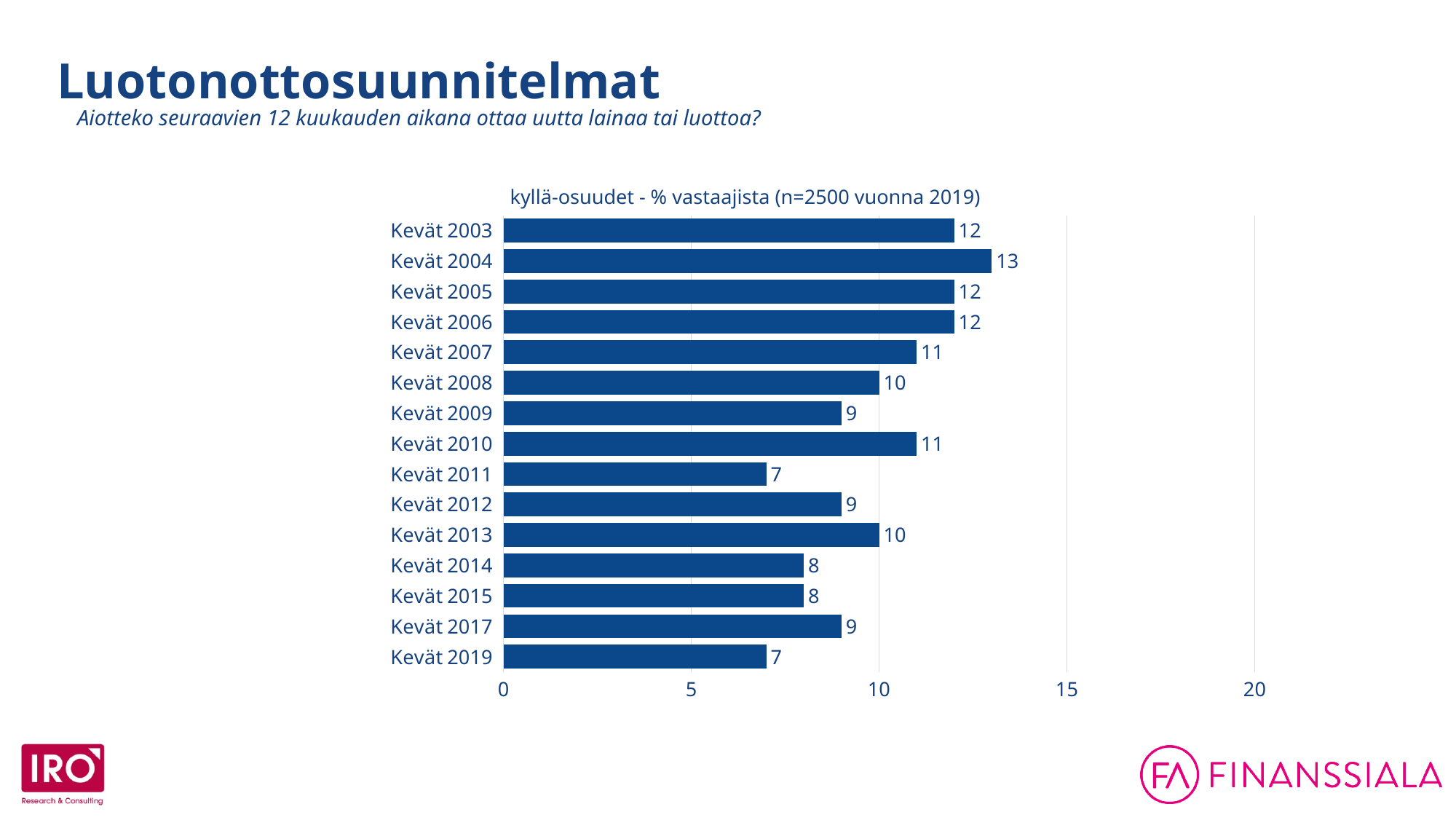
What is the value for Kevät 2019? 7 What is the title of the chart? kyllä-osuudet - % vastaajista (n=2500 vuonna 2019) How many categories are shown in the chart? 15 Which category has the highest value? Kevät 2004 What is the value for Kevät 2013? 10 What kind of chart is shown on the slide? bar chart Which is larger, the value for Kevät 2010 or the value for Kevät 2011? Kevät 2010 Is the value for Kevät 2007 greater or less than 10? greater What is the value for Kevät 2004? 13 Do the values generally rise or fall from Kevät 2003 to Kevät 2019? fall What is the difference between the values for Kevät 2004 and Kevät 2019? 6 What is the difference between the values for Kevät 2003 and Kevät 2008? 2